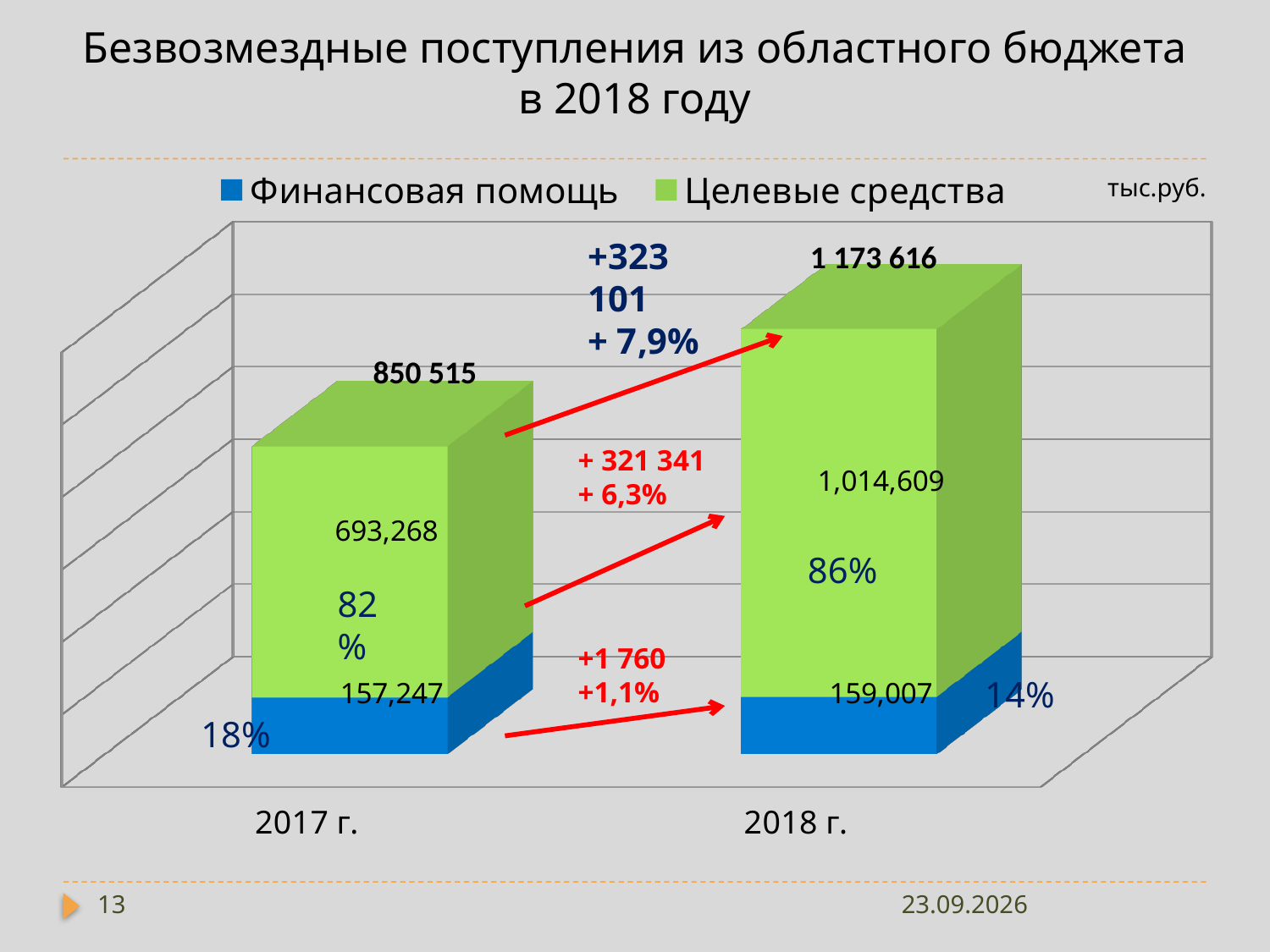
What is the value of Целевые средства for 2018 г.? 1,014,609 What is the value of Финансовая помощь for 2017 г.? 157,247 What is the value of Целевые средства for 2017 г.? 693,268 What is the total of the stacked bar for 2017 г.? 850 515 What is the total of the stacked bar for 2018 г.? 1 173 616 What unit of measurement is indicated for the chart values? тыс.руб. By how much did Финансовая помощь increase from 2017 г. to 2018 г.? 1 760 Which year has the larger total, 2017 г. or 2018 г.? 2018 г. What is the value of Финансовая помощь for 2018 г.? 159,007 How many series does the legend list? 2 By how much did Целевые средства increase from 2017 г. to 2018 г.? 321 341 What kind of chart is shown on the slide? Stacked bar chart